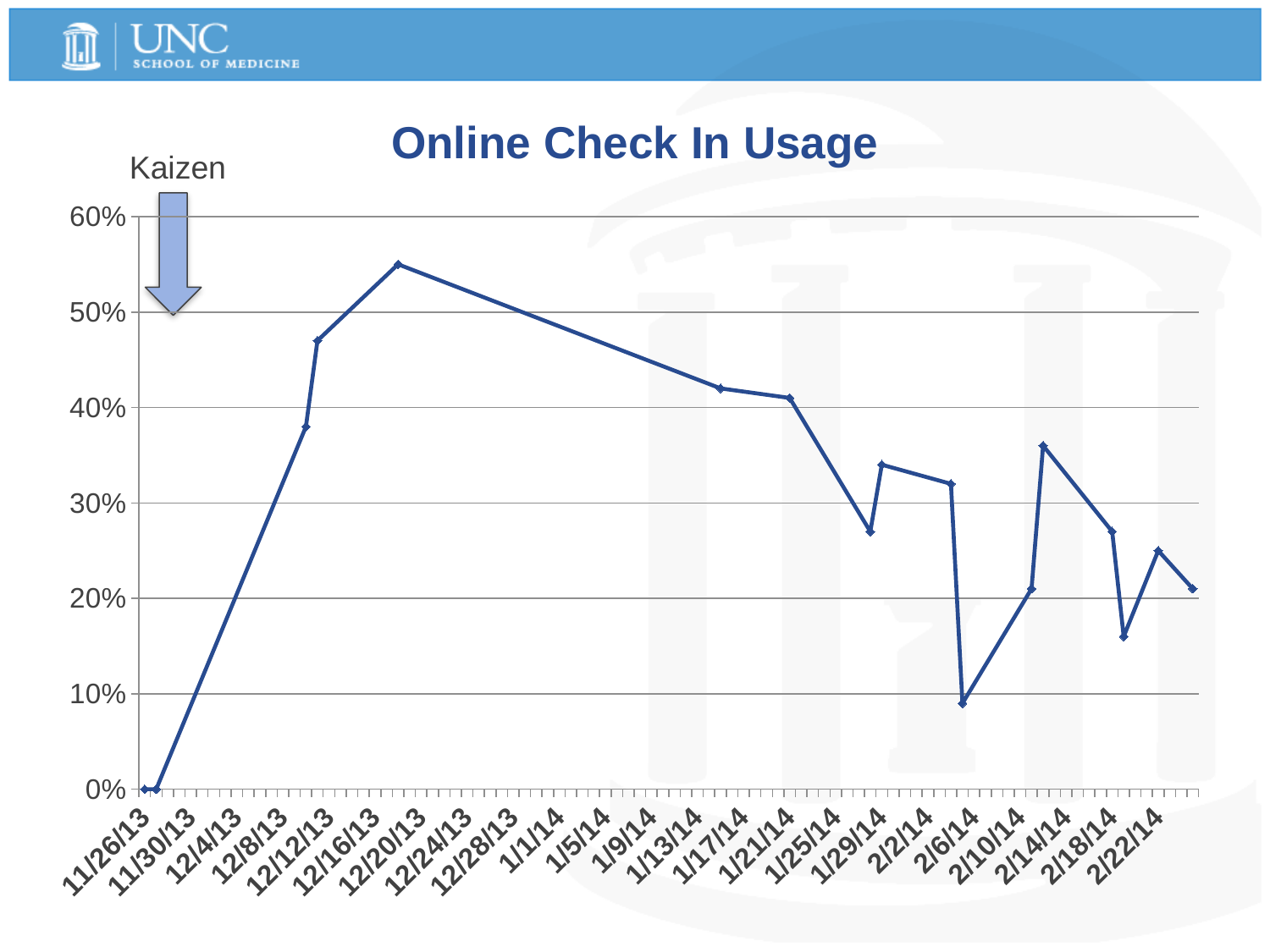
What label is written next to the arrow annotation at the top left of the chart? Kaizen Does the line rise or fall between 11/26/13 and 12/20/13? rise Is the value on 2/6/14 greater or less than 20%? less Is the value on 12/20/13 greater or less than 50%? greater Does the line rise or fall between 12/20/13 and 1/17/14? fall What is the title of the chart? Online Check In Usage What is the Online Check In Usage value on 11/26/13? 0% What type of chart is shown on the slide? line chart Which date has the larger value, 12/20/13 or 2/14/14? 12/20/13 Is the value on 2/14/14 greater or less than 30%? greater